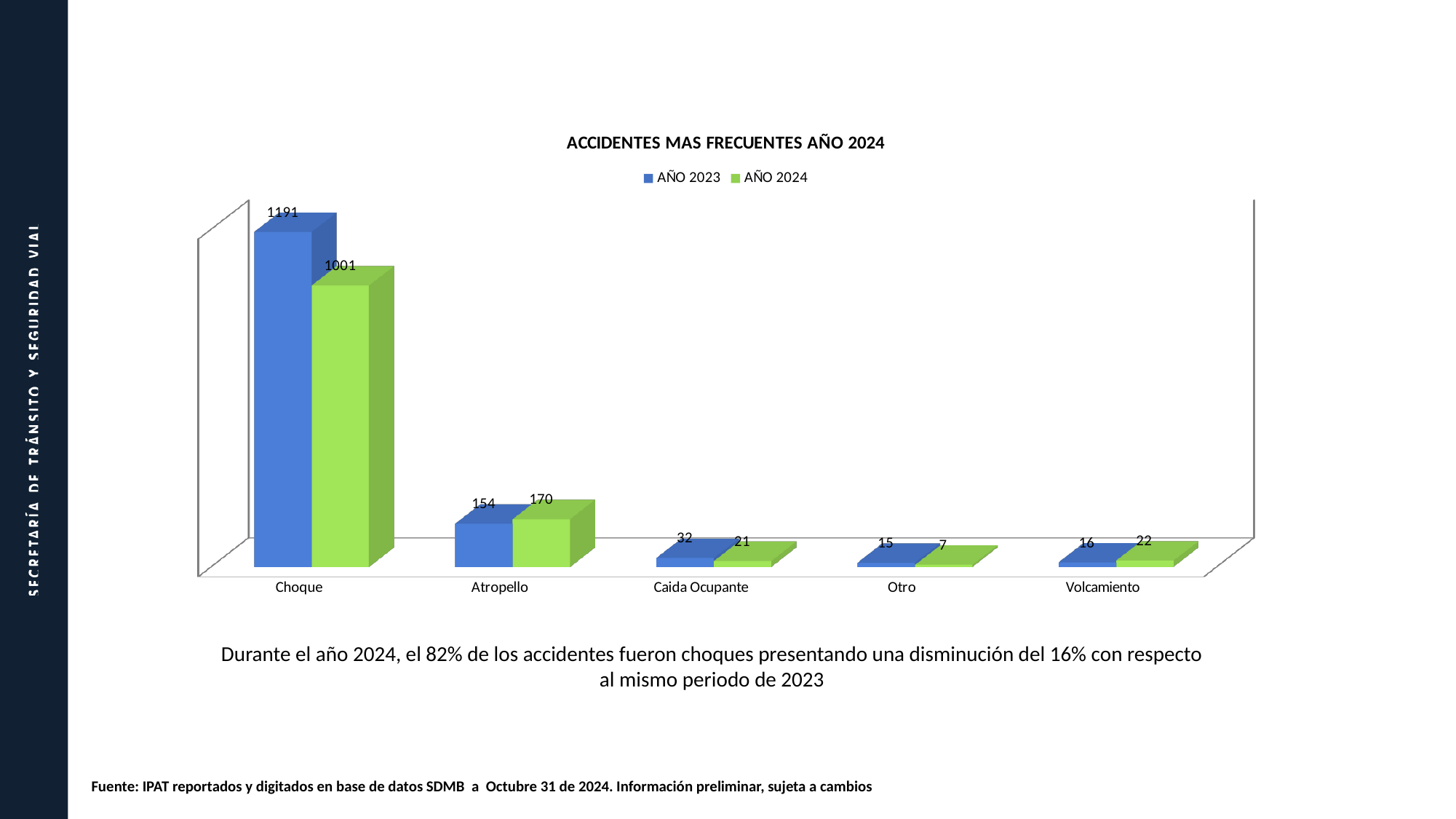
Which category has the lowest value in the AÑO 2024 series? Otro What is the value for Choque in the AÑO 2024 series? 1001 What kind of chart is shown on the slide? Bar chart What is the value for Choque in the AÑO 2023 series? 1191 Which category has the highest value in the AÑO 2024 series? Choque What is the difference between the AÑO 2023 and AÑO 2024 values for Choque? 190 What is the value for Otro in the AÑO 2023 series? 15 What is the title of the chart? ACCIDENTES MAS FRECUENTES AÑO 2024 Which is larger for Atropello: the AÑO 2023 value or the AÑO 2024 value? AÑO 2024 How many categories are shown on the x axis? 5 How many series does the legend list? 2 What is the value for Atropello in the AÑO 2024 series? 170